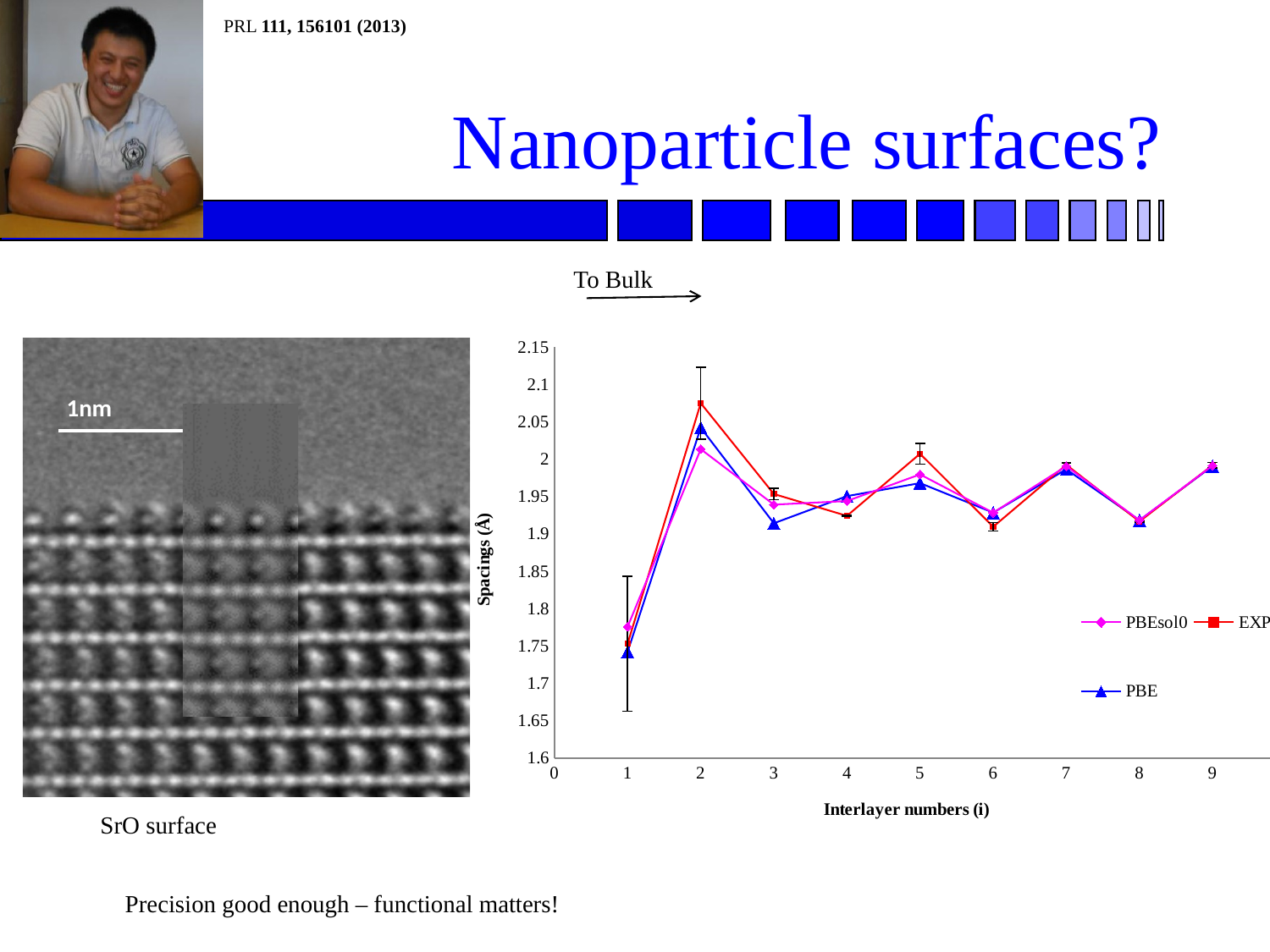
At which interlayer number does the EXP series reach its highest spacing? 2 Do the spacings rise or fall from interlayer number 1 to interlayer number 2? rise How many interlayer numbers (data points) are plotted for each series? 9 Is the PBE value at interlayer number 1 greater or less than 1.8? less At which interlayer number does the PBE series have its lowest spacing? 1 At interlayer number 2, which series has the larger spacing, EXP or PBEsol0? EXP Is the EXP value at interlayer number 2 greater or less than 2.05? greater What is the label of the y axis of the chart? Spacings (Å) What kind of chart is shown on the slide? line chart Is the PBE value at interlayer number 3 greater or less than 1.95? less How many series does the chart legend list? 3 At interlayer number 3, which series has the larger spacing, EXP or PBE? EXP